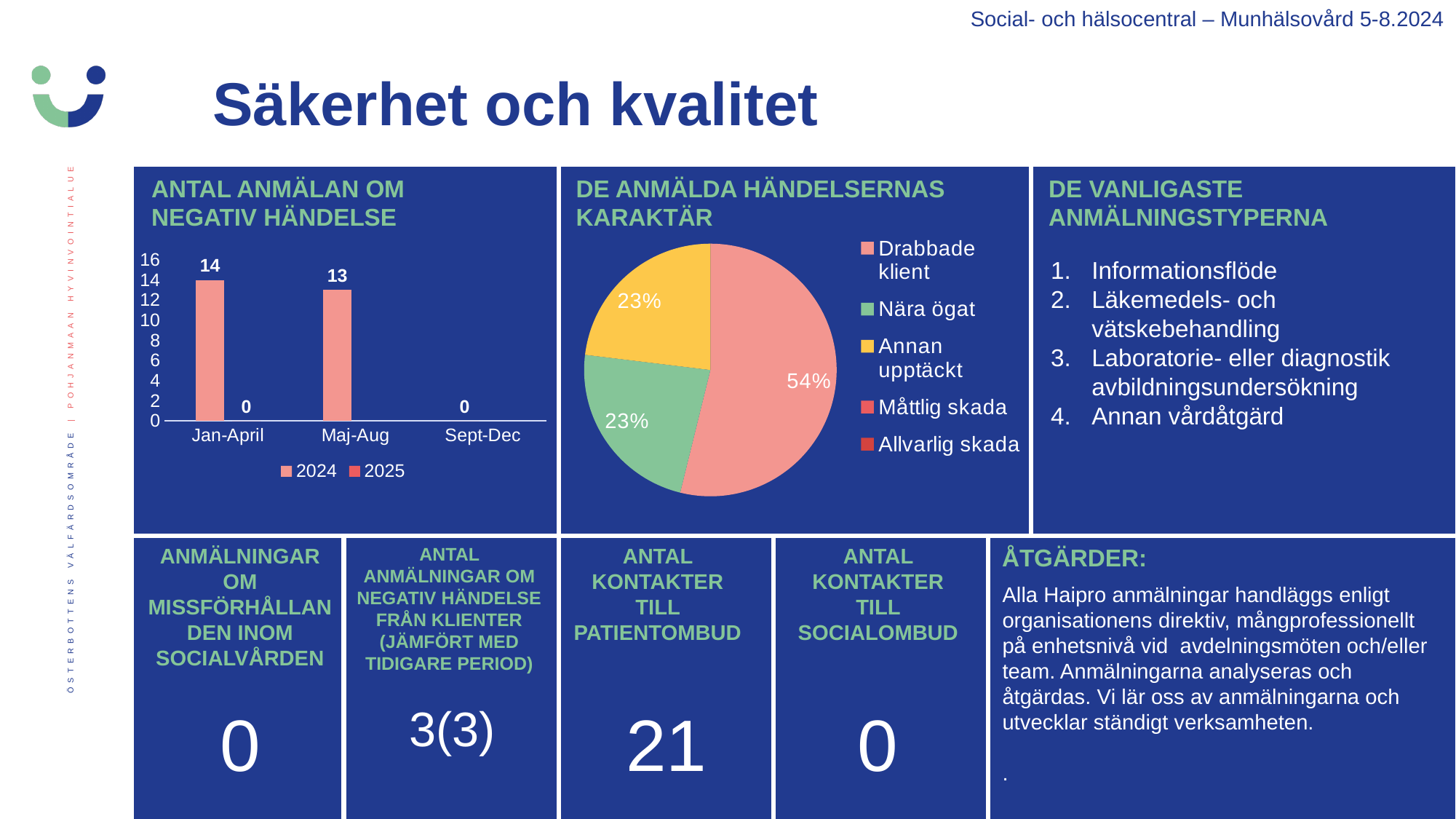
In the chart 'ANTAL ANMÄLAN OM NEGATIV HÄNDELSE', which period has the highest value for 2024? Jan-April What kind of chart is 'ANTAL ANMÄLAN OM NEGATIV HÄNDELSE'? Bar chart In the chart 'ANTAL ANMÄLAN OM NEGATIV HÄNDELSE', what is the value for 2024 in Jan-April? 14 In the pie chart 'DE ANMÄLDA HÄNDELSERNAS KARAKTÄR', which category has the largest slice? Drabbade klient In the pie chart 'DE ANMÄLDA HÄNDELSERNAS KARAKTÄR', how many categories does the legend list? 5 In the chart 'ANTAL ANMÄLAN OM NEGATIV HÄNDELSE', what is the difference between the 2024 values for Jan-April and Maj-Aug? 1 In the chart 'ANTAL ANMÄLAN OM NEGATIV HÄNDELSE', how many series does the legend list? 2 In the chart 'ANTAL ANMÄLAN OM NEGATIV HÄNDELSE', is the 2024 value for Maj-Aug greater or less than 10? greater In the chart 'ANTAL ANMÄLAN OM NEGATIV HÄNDELSE', what is the value for 2024 in Maj-Aug? 13 In the chart 'ANTAL ANMÄLAN OM NEGATIV HÄNDELSE', how many periods are shown on the x axis? 3 In the pie chart 'DE ANMÄLDA HÄNDELSERNAS KARAKTÄR', what share does 'Drabbade klient' have? 54% What kind of chart is 'DE ANMÄLDA HÄNDELSERNAS KARAKTÄR'? Pie chart